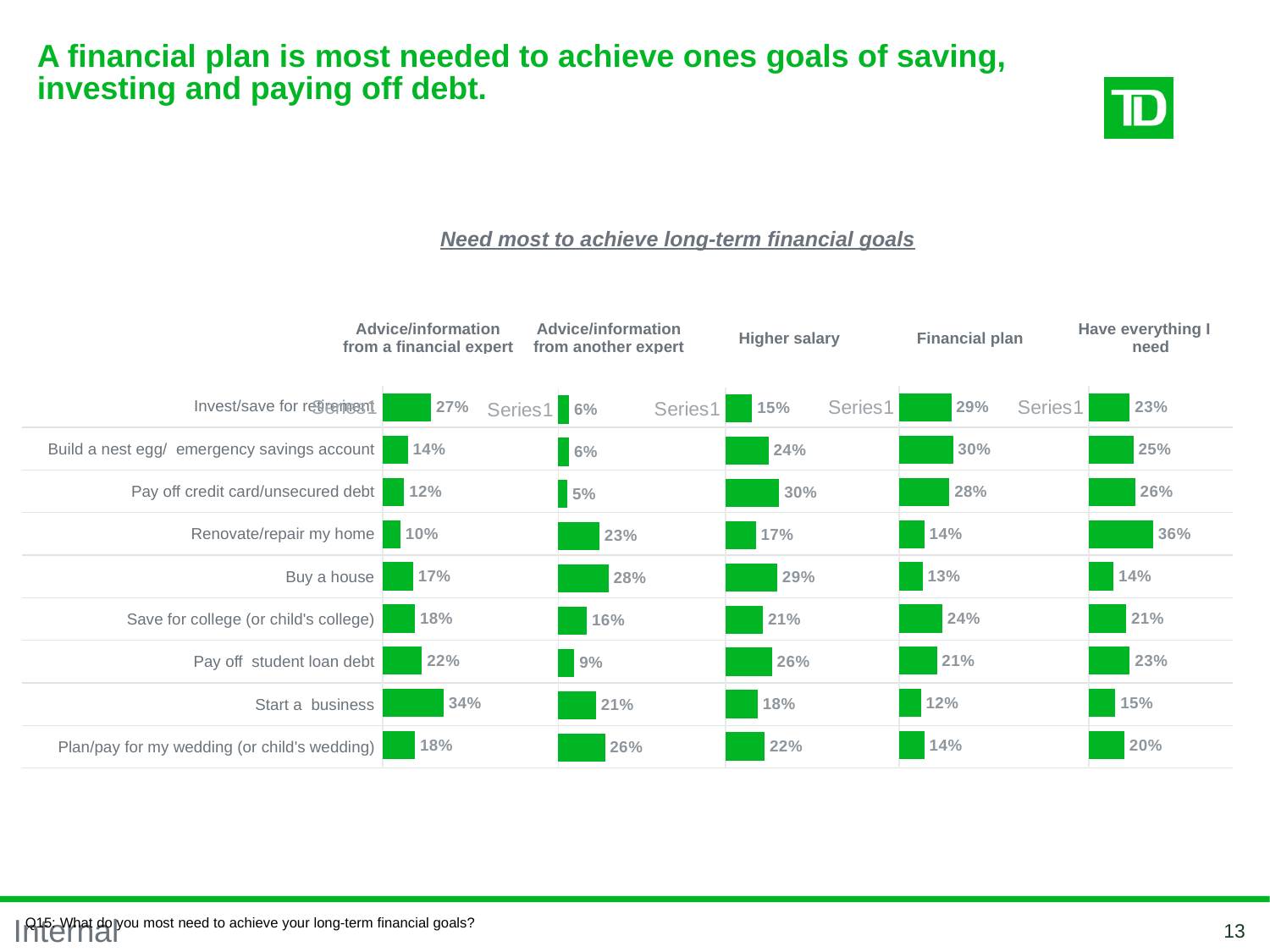
What type of chart is used on this slide? Bar chart How many categories are listed down the left side of the charts? 9 In the "Advice/information from a financial expert" chart, what is the value for Start a business? 34% What is the title shown above the charts? Need most to achieve long-term financial goals In the "Have everything I need" chart, what is the value for Plan/pay for my wedding (or child's wedding)? 20% In the "Financial plan" chart, what is the value for Build a nest egg/ emergency savings account? 30% In the "Advice/information from another expert" chart, which category has the lowest value? Pay off credit card/unsecured debt In the "Have everything I need" chart, what is the value for Renovate/repair my home? 36% In the "Financial plan" chart, what is the difference between Invest/save for retirement and Start a business? 17% In the "Higher salary" chart, which is larger: Buy a house or Invest/save for retirement? Buy a house In the "Higher salary" chart, which category has the highest value? Pay off credit card/unsecured debt In the "Advice/information from a financial expert" chart, which category has the lowest value? Renovate/repair my home